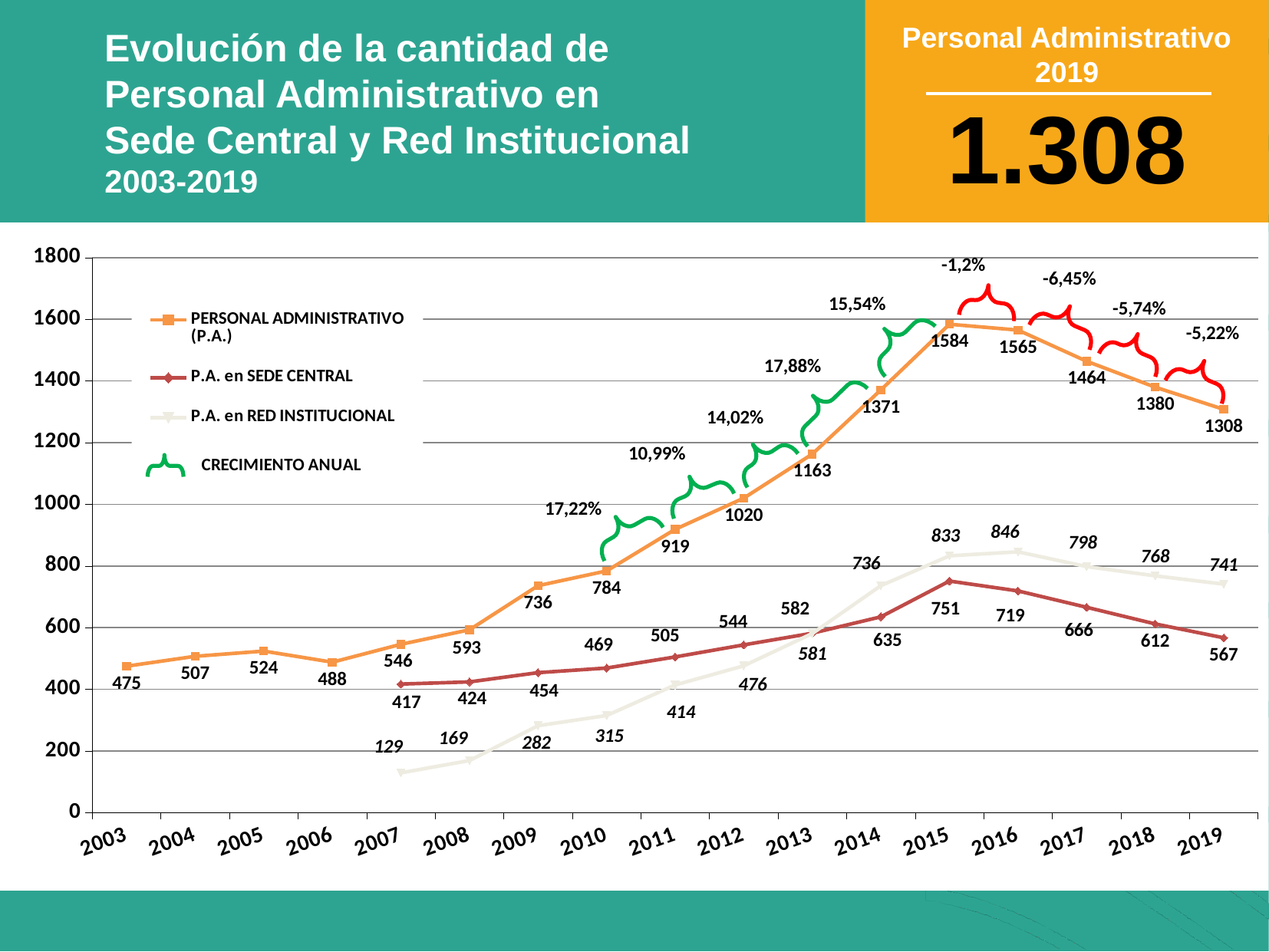
What kind of chart is shown on the slide? Line chart What is the difference between PERSONAL ADMINISTRATIVO (P.A.) in 2015 and in 2019? 276 What is the value of PERSONAL ADMINISTRATIVO (P.A.) in 2019? 1308 Does PERSONAL ADMINISTRATIVO (P.A.) rise or fall from 2015 to 2019? Fall How many years are shown on the x axis? 17 What is the value of P.A. en RED INSTITUCIONAL in 2007? 129 In 2016, which is larger: P.A. en SEDE CENTRAL or P.A. en RED INSTITUCIONAL? P.A. en RED INSTITUCIONAL In which year is PERSONAL ADMINISTRATIVO (P.A.) lowest? 2003 How many entries does the legend list? 4 In which year is PERSONAL ADMINISTRATIVO (P.A.) highest? 2015 What is the value of P.A. en RED INSTITUCIONAL in 2016? 846 What is the value of P.A. en SEDE CENTRAL in 2015? 751